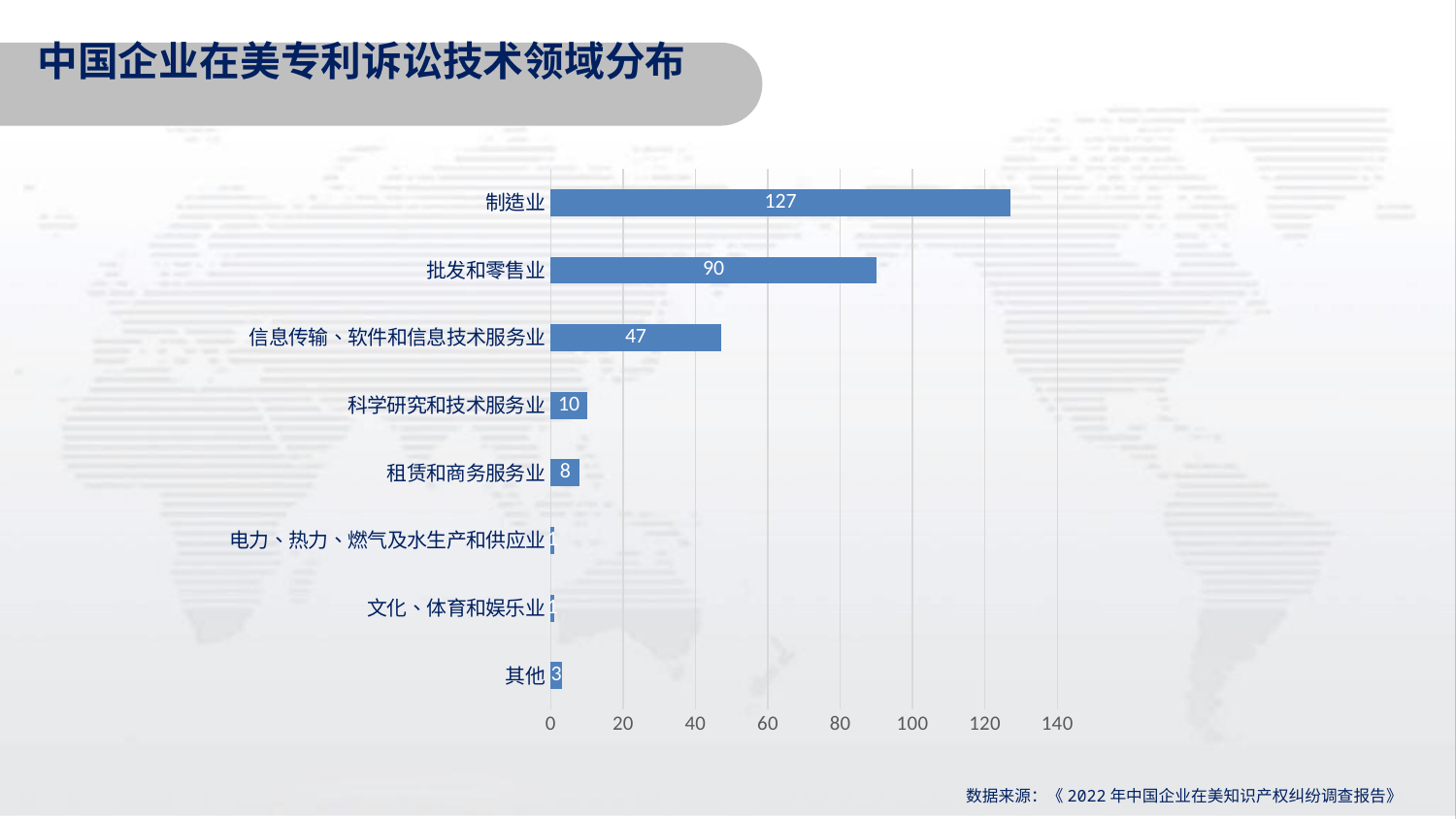
How many categories are shown in the chart? 8 Which category has the highest value? 制造业 What is the value for 其他? 3 What is the value for 批发和零售业? 90 What is the value for 科学研究和技术服务业? 10 Is the value for 电力、热力、燃气及水生产和供应业 greater or less than 20? less What is the value for 租赁和商务服务业? 8 What is the difference between the values for 制造业 and 批发和零售业? 37 What kind of chart is shown on the slide? bar chart What is the value for 制造业? 127 Which is larger, the value for 信息传输、软件和信息技术服务业 or the value for 科学研究和技术服务业? 信息传输、软件和信息技术服务业 What is the value for 信息传输、软件和信息技术服务业? 47